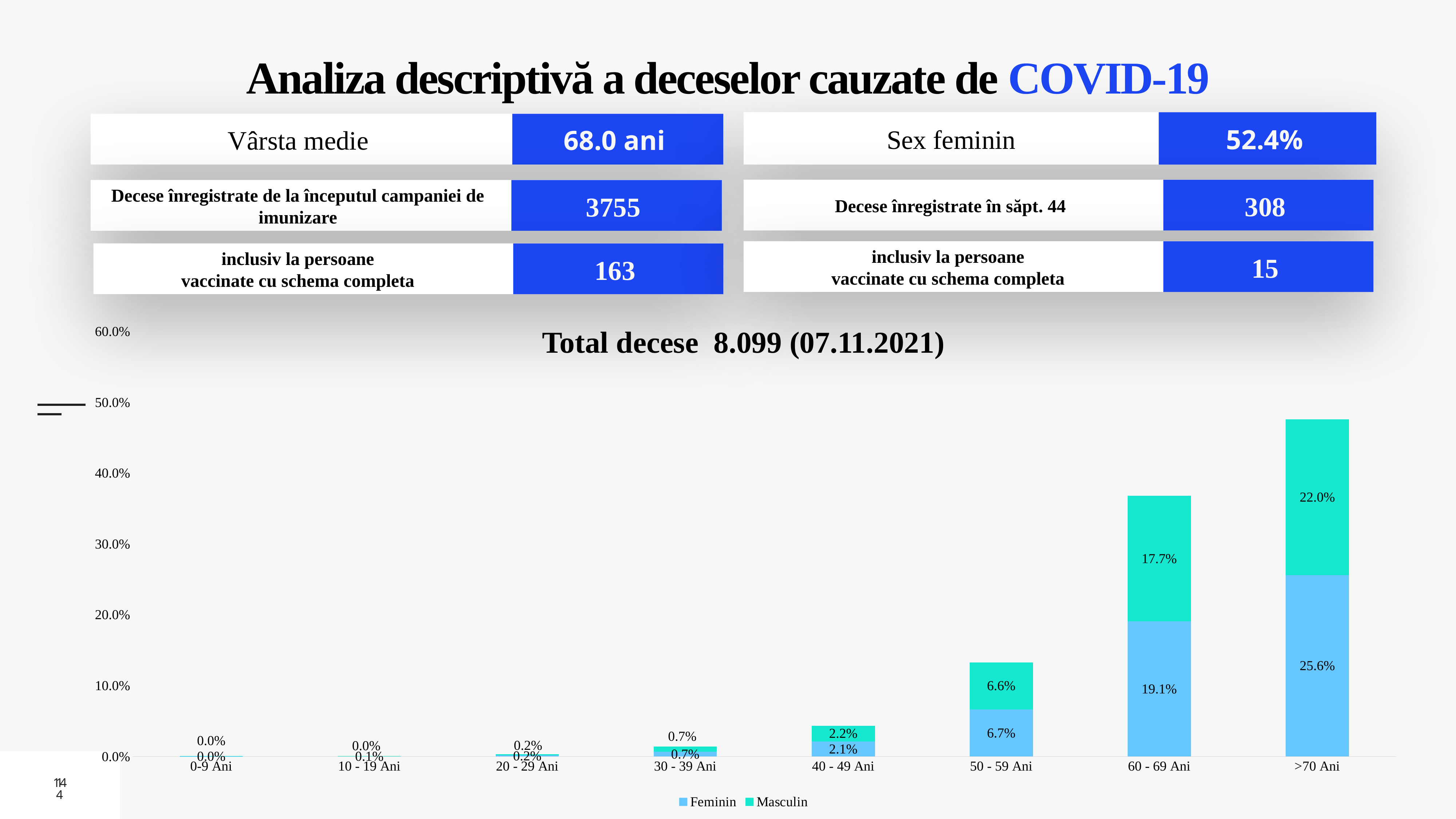
What is the Masculin value for the 60 - 69 Ani category? 17.7% How many age categories are shown on the x axis of the chart? 8 How many series does the chart legend list? 2 Do the stacked bar totals rise or fall as age increases along the x axis? rise What is the total of the stacked bar for the >70 Ani category? 47.6% Is the Feminin value for 60 - 69 Ani larger or smaller than the Masculin value for the same category? larger What is the total of the stacked bar for the 60 - 69 Ani category? 36.8% What is the difference between the Feminin and Masculin values for the >70 Ani category? 3.6% Which age category has the highest Masculin value? >70 Ani What kind of chart is shown on the slide? stacked bar chart What is the Feminin value for the 50 - 59 Ani category? 6.7% What is the Feminin value for the >70 Ani category? 25.6%